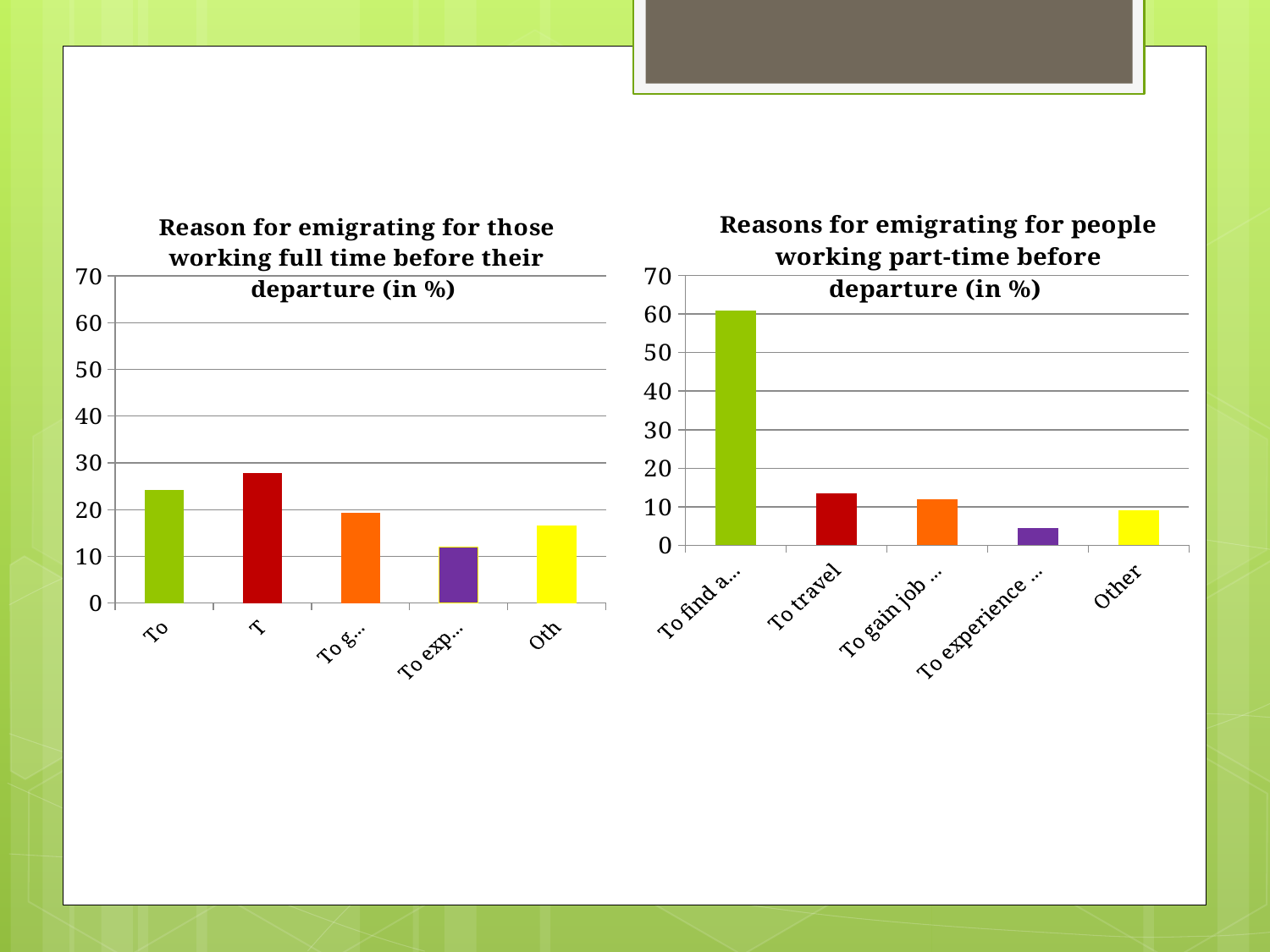
How many bars are shown in the left chart about people working full time before departure? 5 In the right chart (part-time before departure), is the value for "To travel" greater or less than 10? greater In the right chart (part-time before departure), which is larger, the value for "To travel" or the value for "Other"? To travel In the right chart (part-time before departure), is the value for "To travel" greater or less than 20? less What kind of chart is the chart on the left, titled "Reason for emigrating for those working full time before their departure (in %)"? bar chart What kind of chart is the chart on the right, titled "Reasons for emigrating for people working part-time before departure (in %)"? bar chart In the right chart (part-time before departure), is the tallest bar greater or less than 50? greater What colour is the bar for "To travel" in the right chart (part-time before departure)? red How many categories are shown in the right chart about people working part-time before departure? 5 What is the highest value shown on the vertical axis of the right chart (part-time before departure)? 70